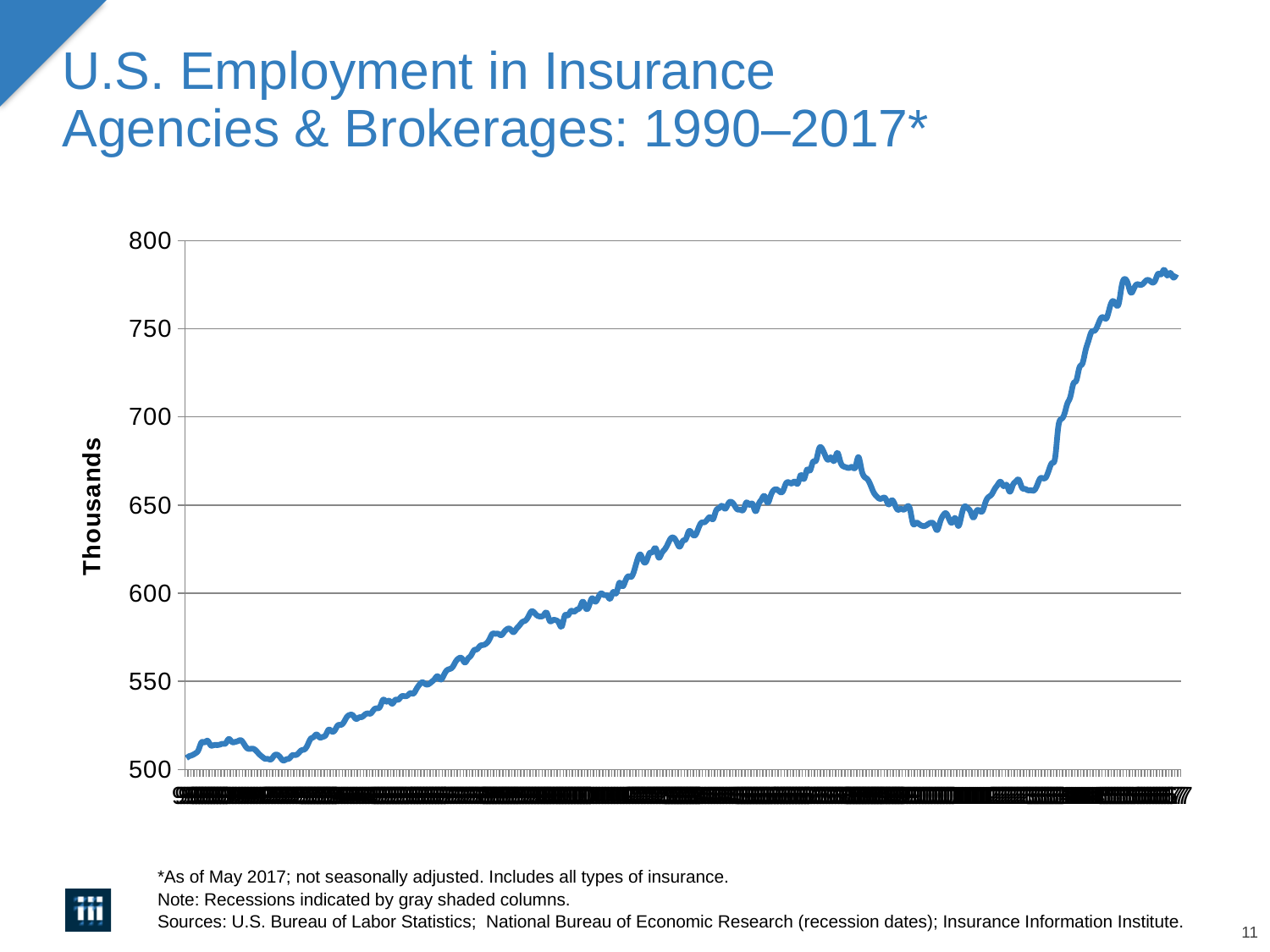
What is the lowest value shown on the vertical axis? 500 What is the label on the vertical axis? Thousands What is the title of the chart on the slide? U.S. Employment in Insurance Agencies & Brokerages: 1990–2017* Is the highest point of the line greater or less than 750? greater How many lines are plotted on the chart? 1 Is the value at the start of the series (1990) greater or less than 550? less What kind of chart is shown on the slide? line chart Is the value at the end of the series (2017) greater or less than 750? greater Does employment in insurance agencies and brokerages generally rise or fall from 1990 to 2017 along the x axis? rise What is the highest value shown on the vertical axis? 800 Is the value at the end of the series (2017) larger or smaller than the value at the start (1990)? larger